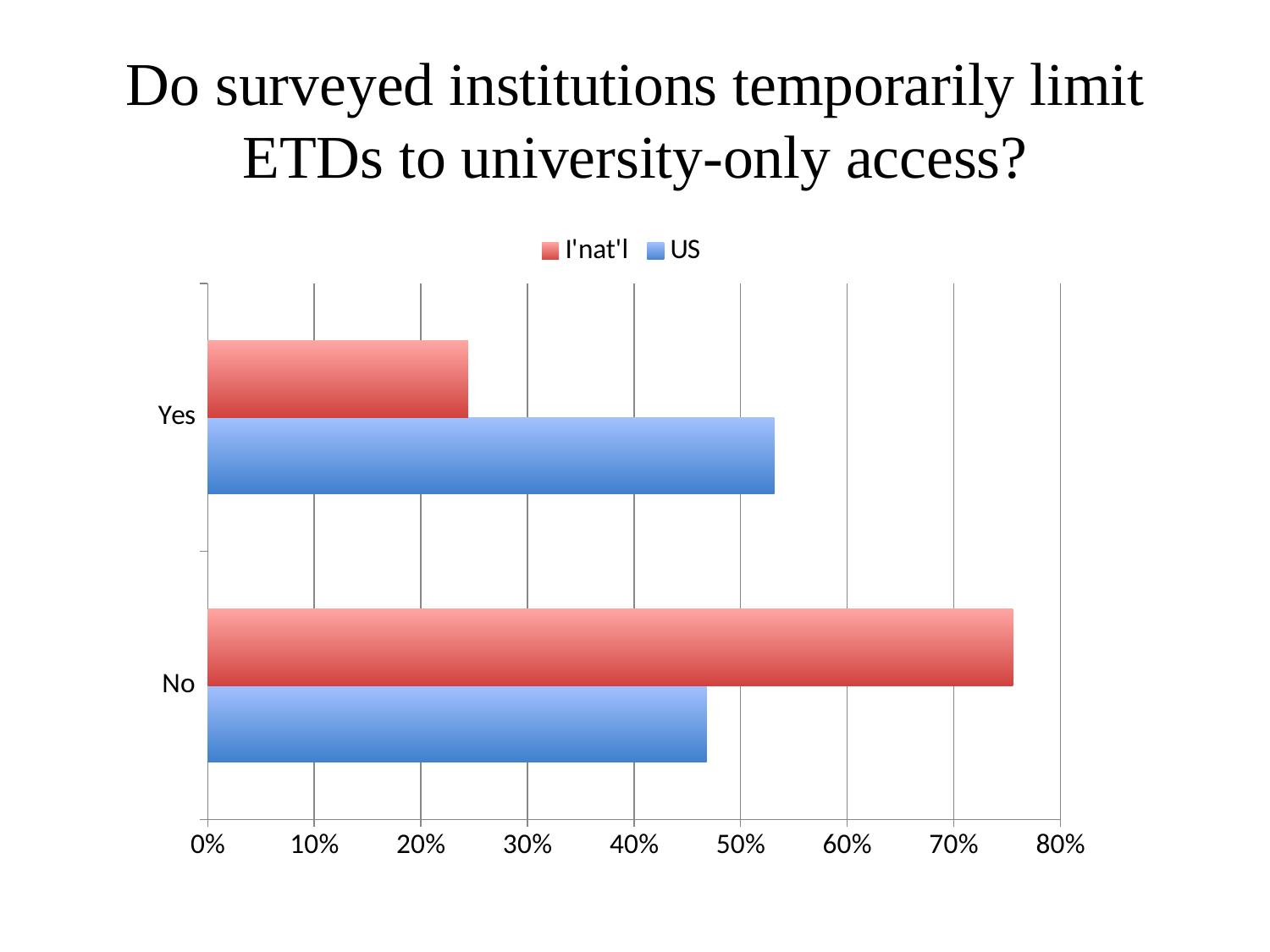
For the Yes category, which series has the larger value, I'nat'l or US? US Which bar is the shortest in the chart? I'nat'l, Yes How many series does the legend list? 2 How many categories are shown on the vertical axis? 2 What kind of chart is shown on the slide? bar chart Which series is shown in blue? US Which series has the highest value in the chart, and for which category? I'nat'l, No Is the I'nat'l value for Yes greater or less than 30%? less Is the US value for Yes greater or less than 50%? greater Is the I'nat'l value for No greater or less than 70%? greater For the No category, which series has the larger value, I'nat'l or US? I'nat'l